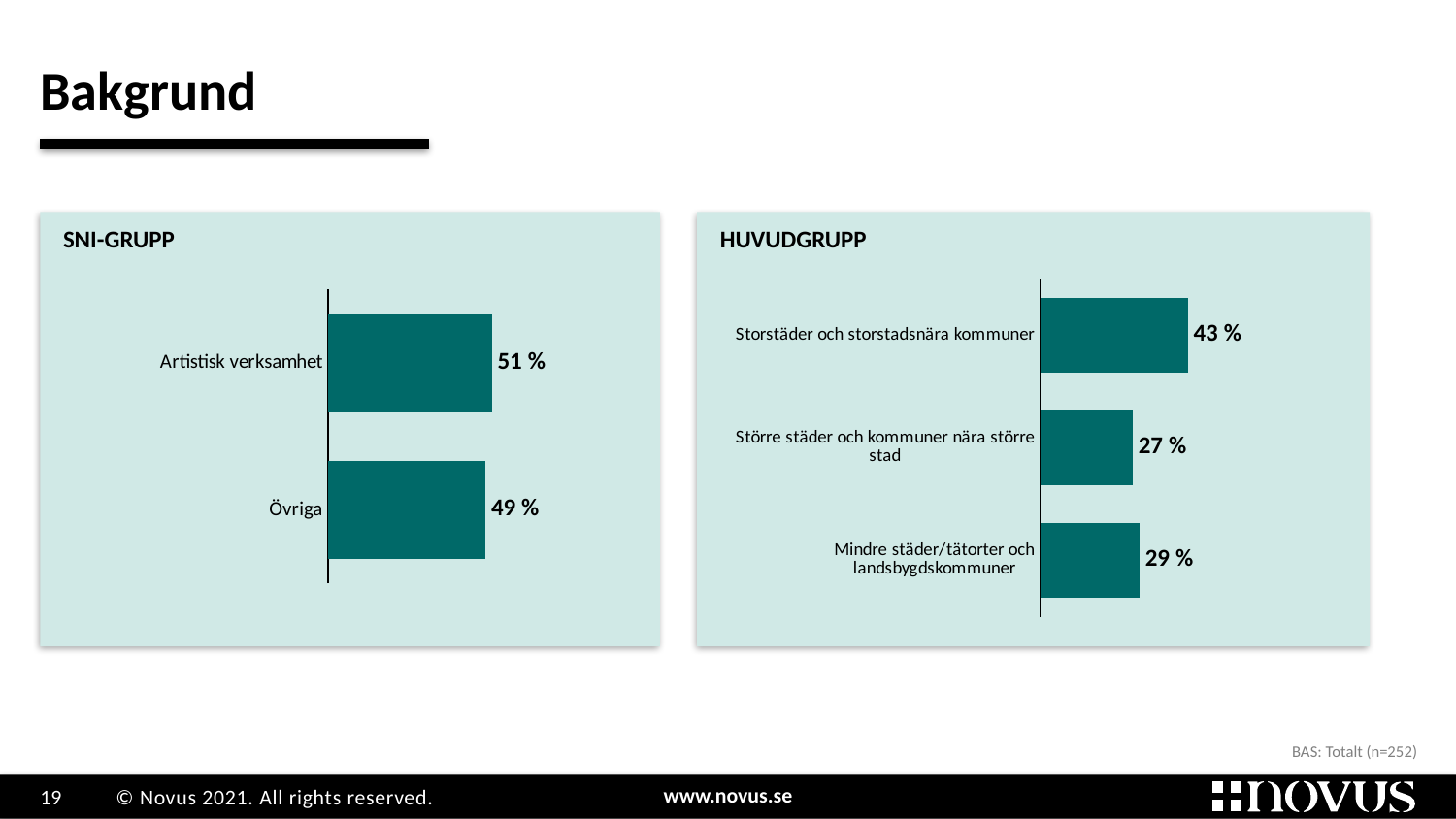
In the HUVUDGRUPP chart, what is the value for Mindre städer/tätorter och landsbygdskommuner? 29 % In the HUVUDGRUPP chart, which category has the highest value? Storstäder och storstadsnära kommuner In the HUVUDGRUPP chart, what is the value for Större städer och kommuner nära större stad? 27 % In the SNI-GRUPP chart, what is the value for Artistisk verksamhet? 51 % In the HUVUDGRUPP chart, how many categories are shown? 3 In the SNI-GRUPP chart, what is the difference between Artistisk verksamhet and Övriga? 2 % In the SNI-GRUPP chart, how many categories are shown? 2 What kind of chart is the HUVUDGRUPP chart? Bar chart In the SNI-GRUPP chart, what is the value for Övriga? 49 % In the HUVUDGRUPP chart, which category has the lowest value? Större städer och kommuner nära större stad In the HUVUDGRUPP chart, what is the value for Storstäder och storstadsnära kommuner? 43 % In the HUVUDGRUPP chart, what is the difference between Storstäder och storstadsnära kommuner and Mindre städer/tätorter och landsbygdskommuner? 14 %